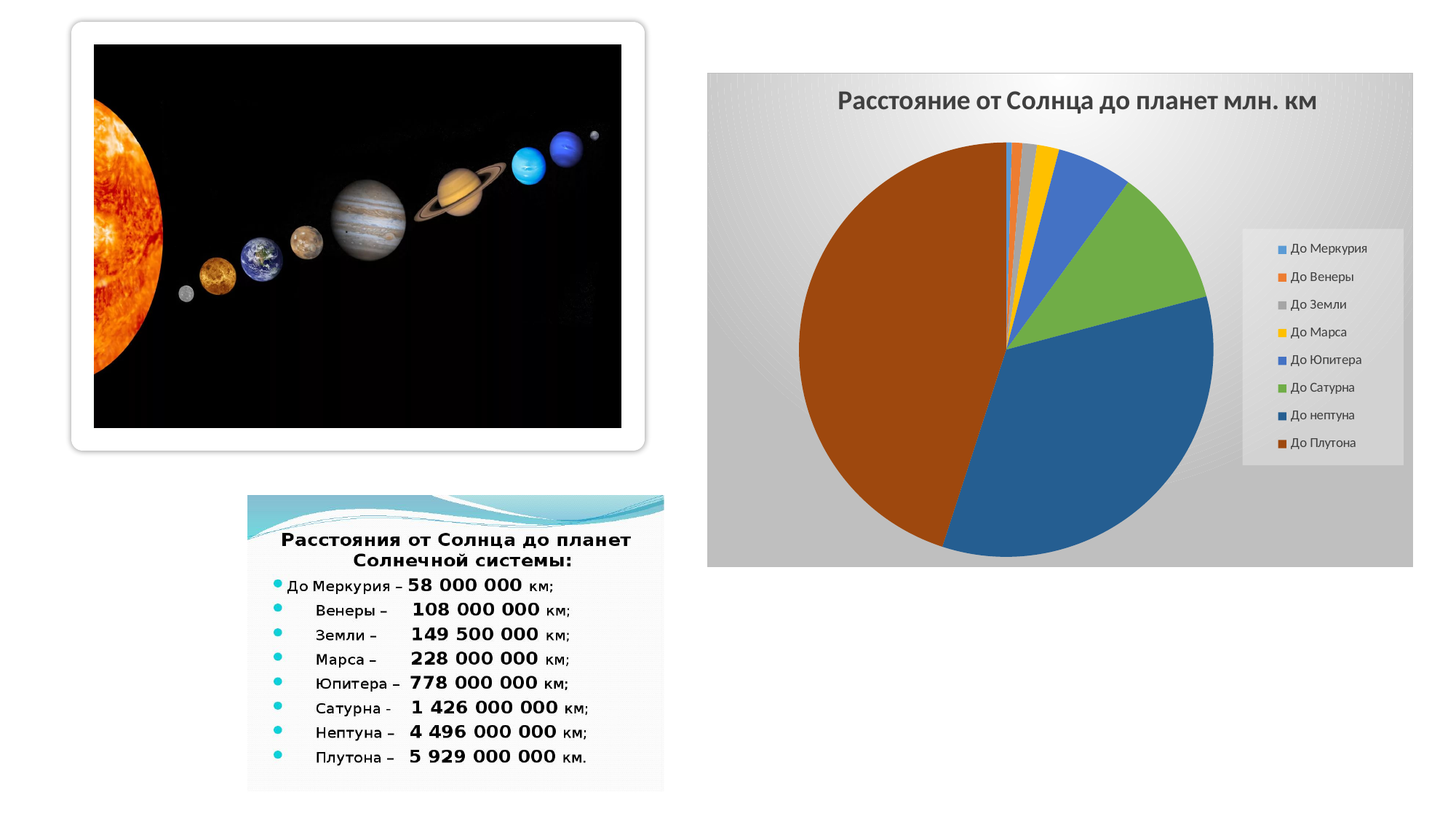
Which planet has the largest slice in the pie chart? До Плутона Which planet has the smallest slice in the pie chart? До Меркурия How many slices does the pie chart have? 8 Which slice is larger in the pie chart, До нептуна or До Сатурна? До нептуна Which slice is larger in the pie chart, До Сатурна or До Юпитера? До Сатурна How many entries does the legend of the pie chart list? 8 What is the title of the pie chart? Расстояние от Солнца до планет млн. км What colour is the slice for До Плутона in the pie chart? brown Which slice is larger in the pie chart, До Юпитера or До Марса? До Юпитера What kind of chart is shown on the slide? pie chart